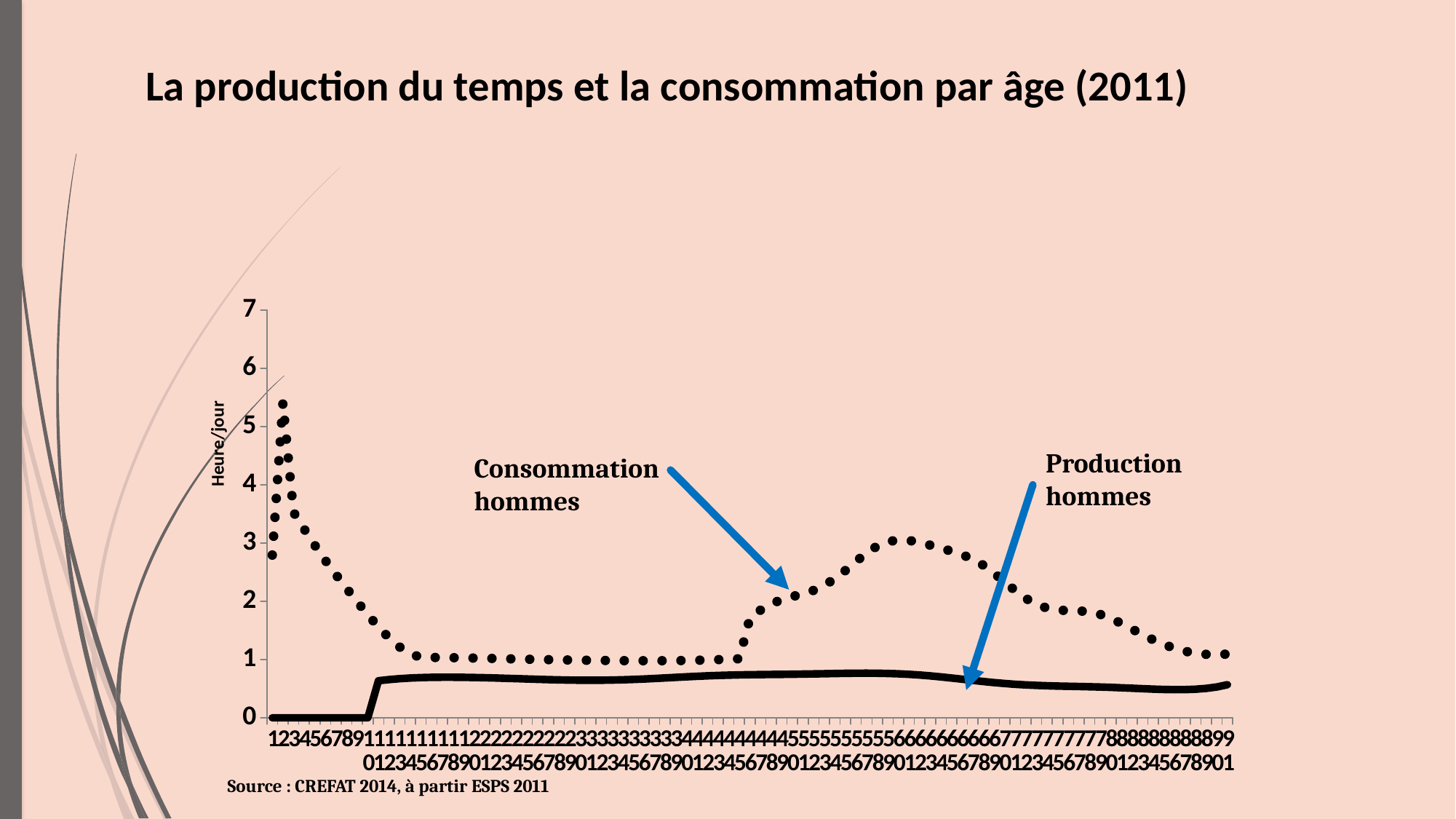
Does Consommation hommes rise or fall between age 2 and age 15? fall How many data series are plotted on the chart? 2 Is the peak value of Consommation hommes (around age 2) greater or less than 5? greater Is the value of Production hommes at age 5 greater or less than 1? less Is the value of Consommation hommes at age 1 greater or less than 2? greater What kind of chart is shown on the slide? line chart At age 60, which series has the higher value, Consommation hommes or Production hommes? Consommation hommes Which series is drawn as a dotted line? Consommation hommes Does Consommation hommes rise or fall between age 45 and age 58? rise What is the title of the chart on the slide? La production du temps et la consommation par âge (2011)